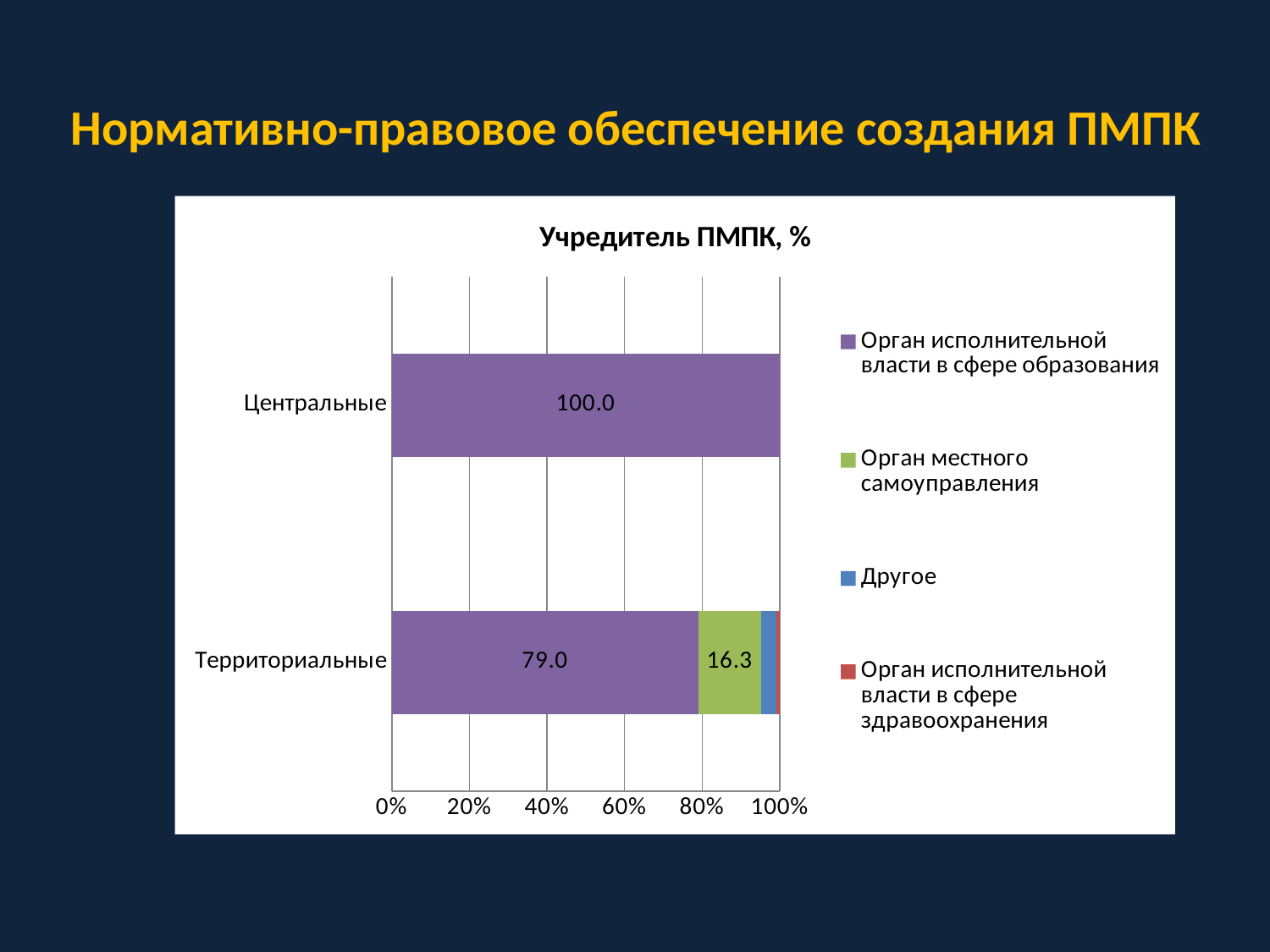
How many series does the legend list? 4 What colour represents Орган местного самоуправления in the chart? Green Which category has the larger value for Орган исполнительной власти в сфере образования, Центральные or Территориальные? Центральные Is the value for Орган исполнительной власти в сфере образования for Территориальные greater or less than 60%? greater What is the difference between the Орган исполнительной власти в сфере образования values for Центральные and Территориальные? 21.0 What is the title of the chart? Учредитель ПМПК, % What is the value for Орган местного самоуправления for Территориальные? 16.3 What is the value for Орган исполнительной власти в сфере образования for Территориальные? 79.0 What is the value for Орган исполнительной власти в сфере образования for Центральные? 100.0 Which category has the highest value for Орган исполнительной власти в сфере образования? Центральные How many categories are shown on the vertical axis? 2 What kind of chart is shown on the slide? Stacked bar chart